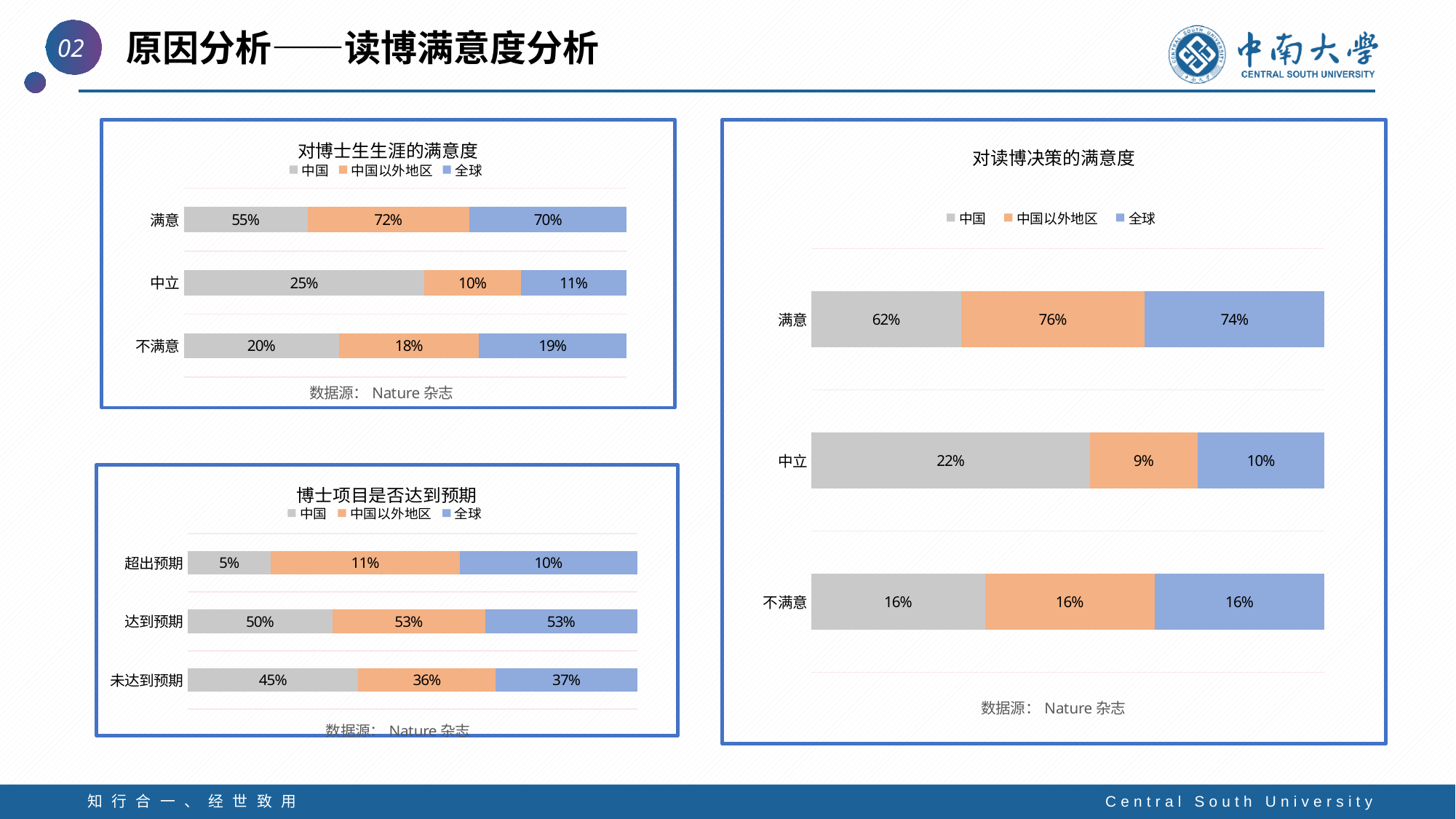
In the chart titled 博士项目是否达到预期, which is larger for 未达到预期: the 中国 value or the 全球 value? 中国 In the chart titled 博士项目是否达到预期, how many categories are shown? 3 In the chart titled 博士项目是否达到预期, what is the value for 中国 in the 超出预期 category? 5% In the chart titled 博士项目是否达到预期, which category has the highest value for 中国? 达到预期 In the chart titled 对博士生生涯的满意度, how many series does the legend list? 3 In the chart titled 对读博决策的满意度, which category has the lowest value for 中国以外地区? 中立 What kind of chart is the chart titled 对读博决策的满意度? Stacked bar chart In the chart titled 对博士生生涯的满意度, what is the difference between the 中国以外地区 and 中国 values for 满意? 17% In the chart titled 对博士生生涯的满意度, what is the value for 中国 in the 满意 category? 55% In the chart titled 对博士生生涯的满意度, what is the value for 全球 in the 中立 category? 11% In the chart titled 对读博决策的满意度, what is the value for 中国以外地区 in the 满意 category? 76% In the chart titled 对读博决策的满意度, what is the difference between the 中国 and 全球 values for 中立? 12%